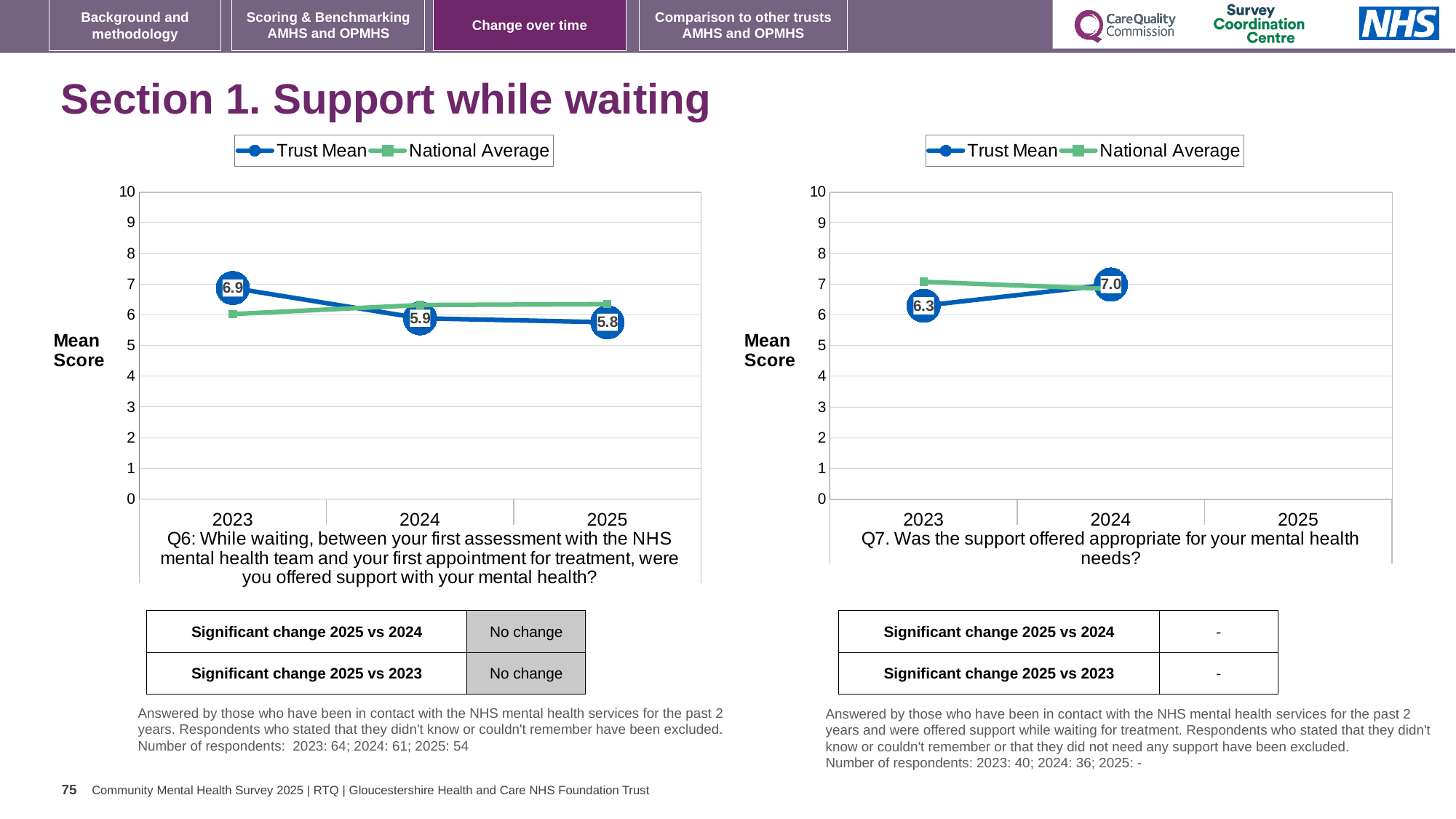
What kind of chart is the Q6 chart (left)? line chart On the Q7 chart (right), which year has the lowest labelled Trust Mean? 2023 On the Q6 chart (left), is the National Average for 2023 greater or less than 7? less How many series does the legend of the Q7 chart (right) list? 2 On the Q6 chart (left), does the Trust Mean rise or fall from 2023 to 2025? fall On the Q7 chart (right), what is the difference between the Trust Mean in 2024 and in 2023? 0.7 On the Q6 chart (left), which year has the highest Trust Mean? 2023 On the Q6 chart (left), what is the difference between the Trust Mean in 2023 and in 2025? 1.1 On the Q6 chart (left), is the Trust Mean higher in 2023 or in 2024? 2023 On the Q6 chart (left), what is the Trust Mean for 2023? 6.9 On the Q7 chart (right), what is the Trust Mean for 2024? 7.0 On the Q6 chart (left), what is the Trust Mean for 2025? 5.8